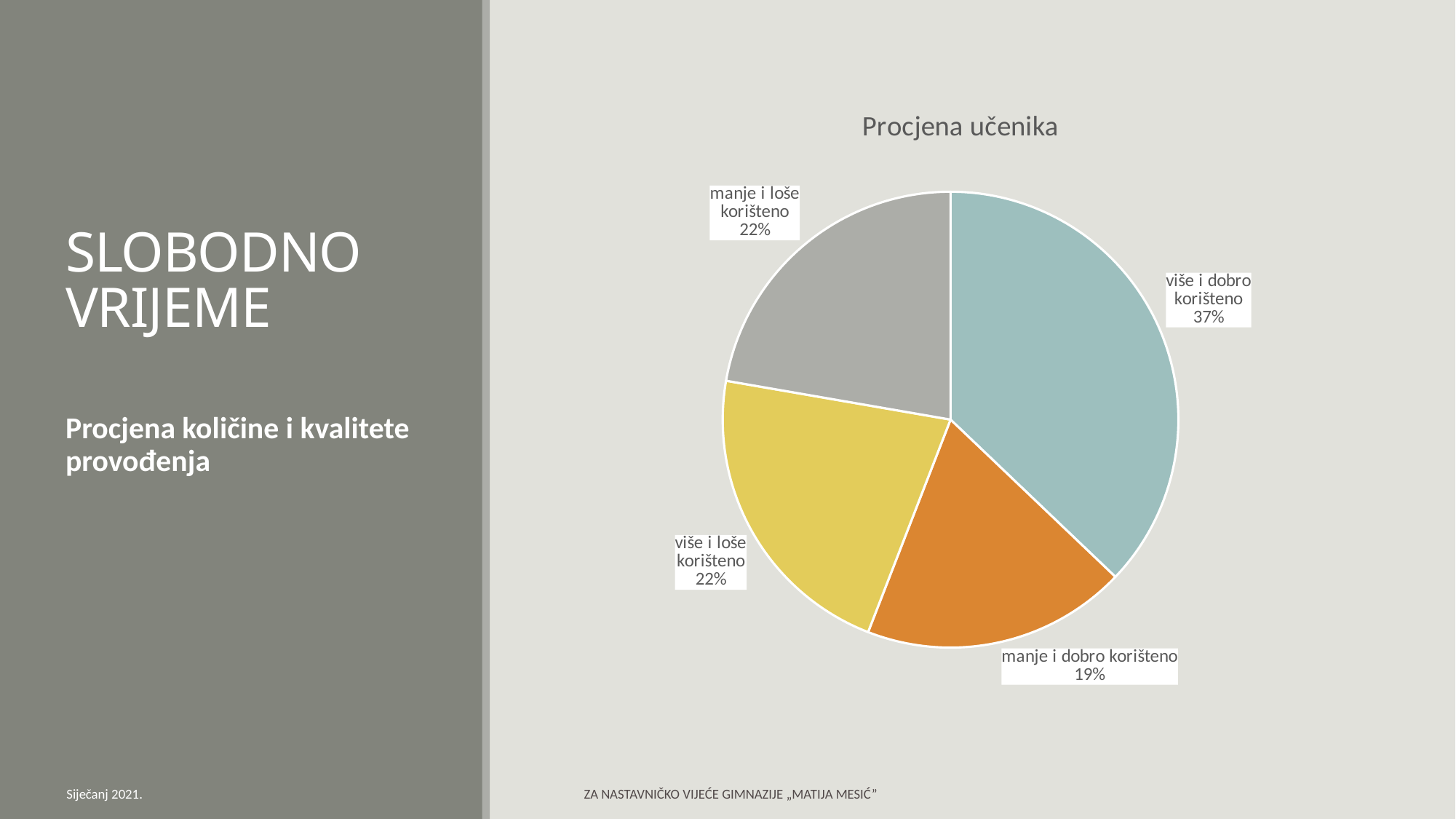
Which is larger, the slice for "više i loše korišteno" or the slice for "manje i dobro korišteno"? više i loše korišteno What colour is the slice for "manje i dobro korišteno"? orange What share of the pie is labelled "više i dobro korišteno"? 37% What is the title of the chart? Procjena učenika What share of the pie is labelled "manje i loše korišteno"? 22% How many slices does the pie chart have? 4 What is the difference in percentage points between "više i dobro korišteno" and "manje i dobro korišteno"? 18 Which category has the largest slice of the pie? više i dobro korišteno Which category has the smallest slice of the pie? manje i dobro korišteno What share of the pie is labelled "više i loše korišteno"? 22% What type of chart is shown on the slide? pie chart What share of the pie is labelled "manje i dobro korišteno"? 19%